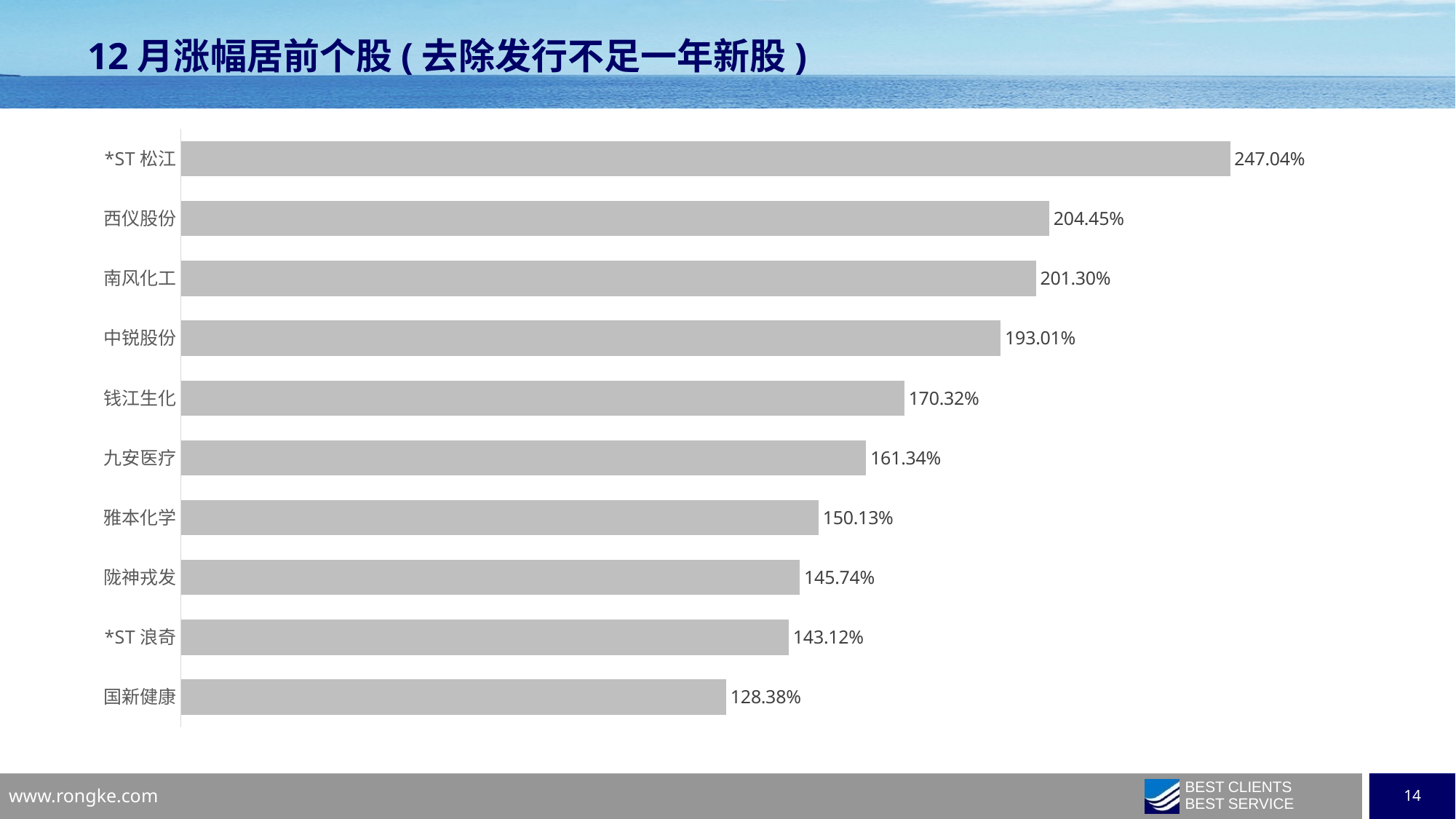
What is the title of the slide? 12 月涨幅居前个股（去除发行不足一年新股） What is the value for 钱江生化? 170.32% Which is larger, the value for 九安医疗 or the value for 雅本化学? 九安医疗 Which stock has the lowest value? 国新健康 What is the value for *ST 松江? 247.04% Which stock has the highest value? *ST 松江 What kind of chart is shown on the slide? Bar chart What is the value for 陇神戎发? 145.74% How many stocks are shown in the chart? 10 Which is larger, the value for 中锐股份 or the value for *ST 浪奇? 中锐股份 What is the difference between the values for 西仪股份 and 南风化工? 3.15% What is the difference between the values for *ST 松江 and 国新健康? 118.66%